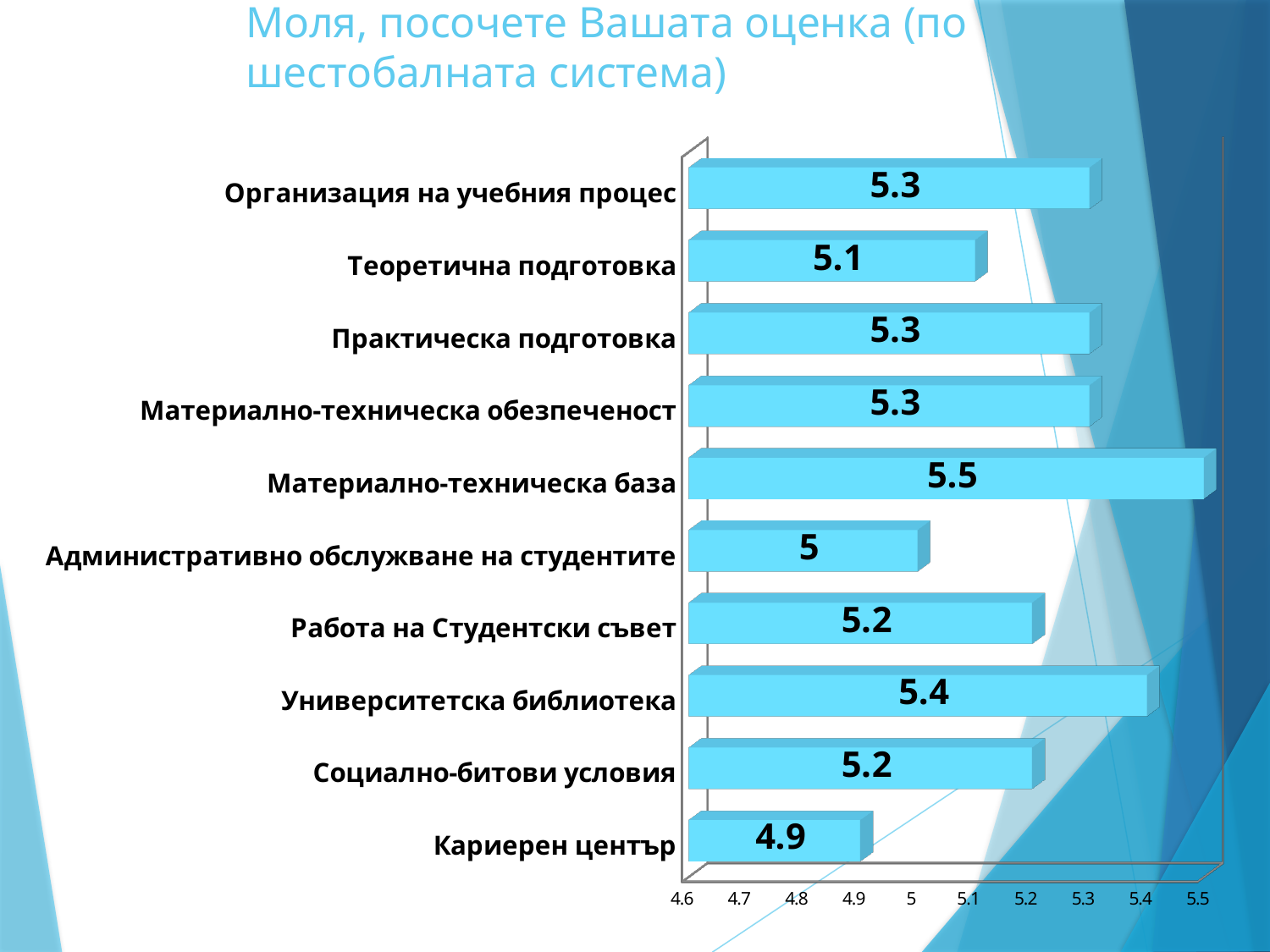
Which category has the highest value? Материално-техническа база What is the difference between the values for Материално-техническа база and Кариерен център? 0.6 What is the value for Кариерен център? 4.9 What kind of chart is shown on the slide? bar chart What is the difference between the values for Университетска библиотека and Работа на Студентски съвет? 0.2 What is the title of the chart? Моля, посочете Вашата оценка (по шестобалната система) How many categories are shown in the chart? 10 Which is larger, the value for Теоретична подготовка or the value for Практическа подготовка? Практическа подготовка What is the value for Материално-техническа база? 5.5 Which category has the lowest value? Кариерен център What is the value for Административно обслужване на студентите? 5 What is the value for Университетска библиотека? 5.4